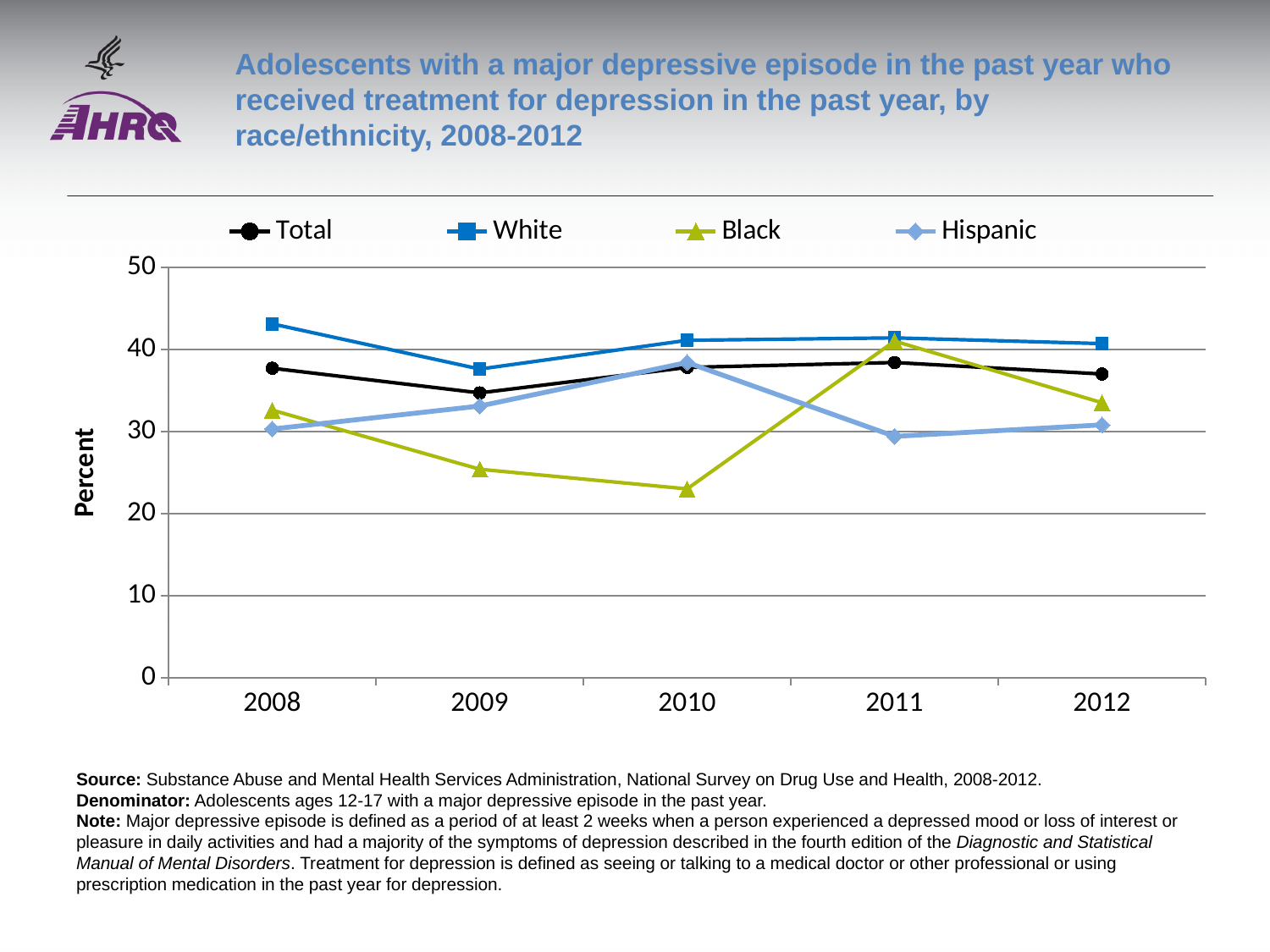
Is the value for Black in 2010 greater or less than 30? less What kind of chart is shown on the slide? line chart What is the label on the y axis? Percent In which year is the value for Hispanic highest? 2010 How many series does the legend list? 4 Is the value for White in 2008 greater or less than 40? greater In 2009, which is larger, the value for White or the value for Black? White In which year is the value for White highest? 2008 How many years are shown on the x axis? 5 In which year is the value for Black lowest? 2010 Does the value for Black rise or fall from 2008 to 2010? fall Is the value for Total in 2009 greater or less than 40? less